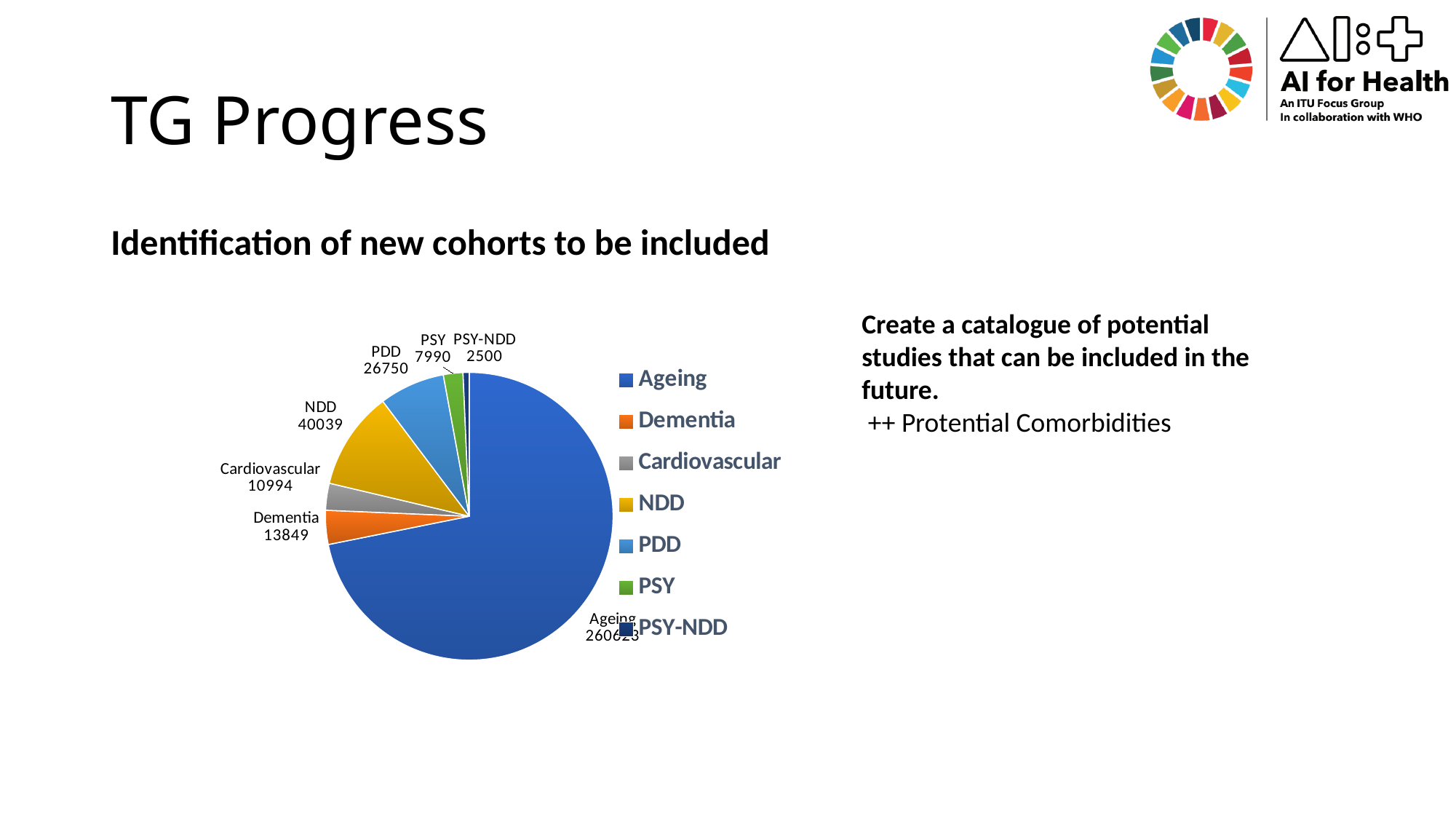
What is the difference between the values for NDD and PDD? 13289 Which is larger, the value for Dementia or the value for Cardiovascular? Dementia Which category has the largest slice of the pie chart? Ageing What is the value for Cardiovascular in the pie chart? 10994 What is the value for Dementia in the pie chart? 13849 What is the value for PDD in the pie chart? 26750 What colour is the NDD slice in the pie chart? yellow Which category has the smallest slice of the pie chart? PSY-NDD What kind of chart is shown on the slide? pie chart How many categories are shown in the pie chart? 7 What is the value for PSY-NDD in the pie chart? 2500 What is the value for NDD in the pie chart? 40039